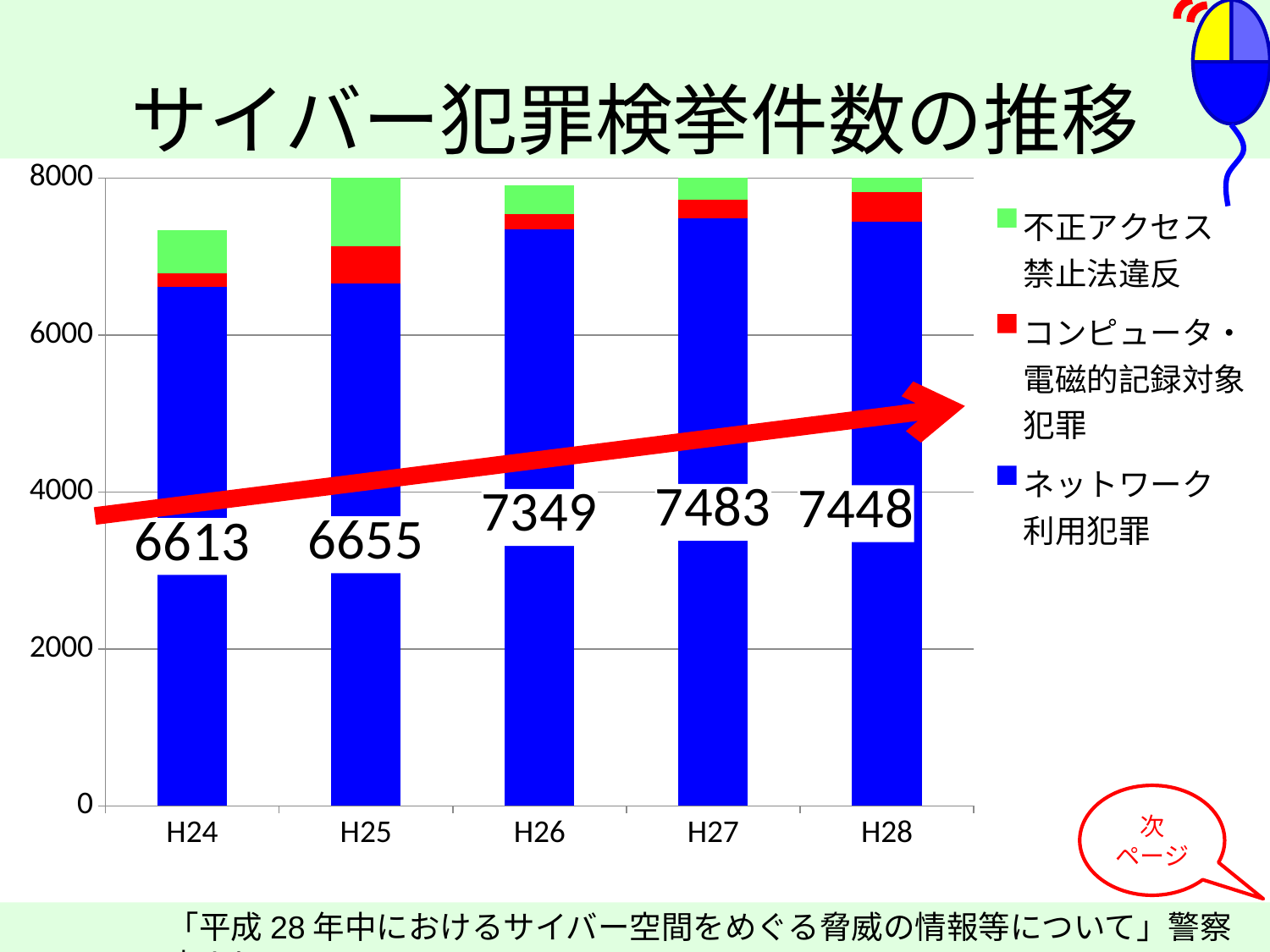
What is the value of ネットワーク利用犯罪 for H24? 6613 What kind of chart is shown on the slide? Stacked bar chart Is the total height of the stacked bar for H24 greater or less than 7000? greater How many series does the legend list? 3 How many years are shown on the x axis? 5 What is the difference between the ネットワーク利用犯罪 values for H26 and H25? 694 What is the value of ネットワーク利用犯罪 for H28? 7448 Which colour represents 不正アクセス禁止法違反 in the legend? Green In which year is the labelled value for ネットワーク利用犯罪 lowest? H24 Which is larger, the ネットワーク利用犯罪 value for H27 or for H28? H27 In which year is the labelled value for ネットワーク利用犯罪 highest? H27 What is the value of ネットワーク利用犯罪 for H26? 7349